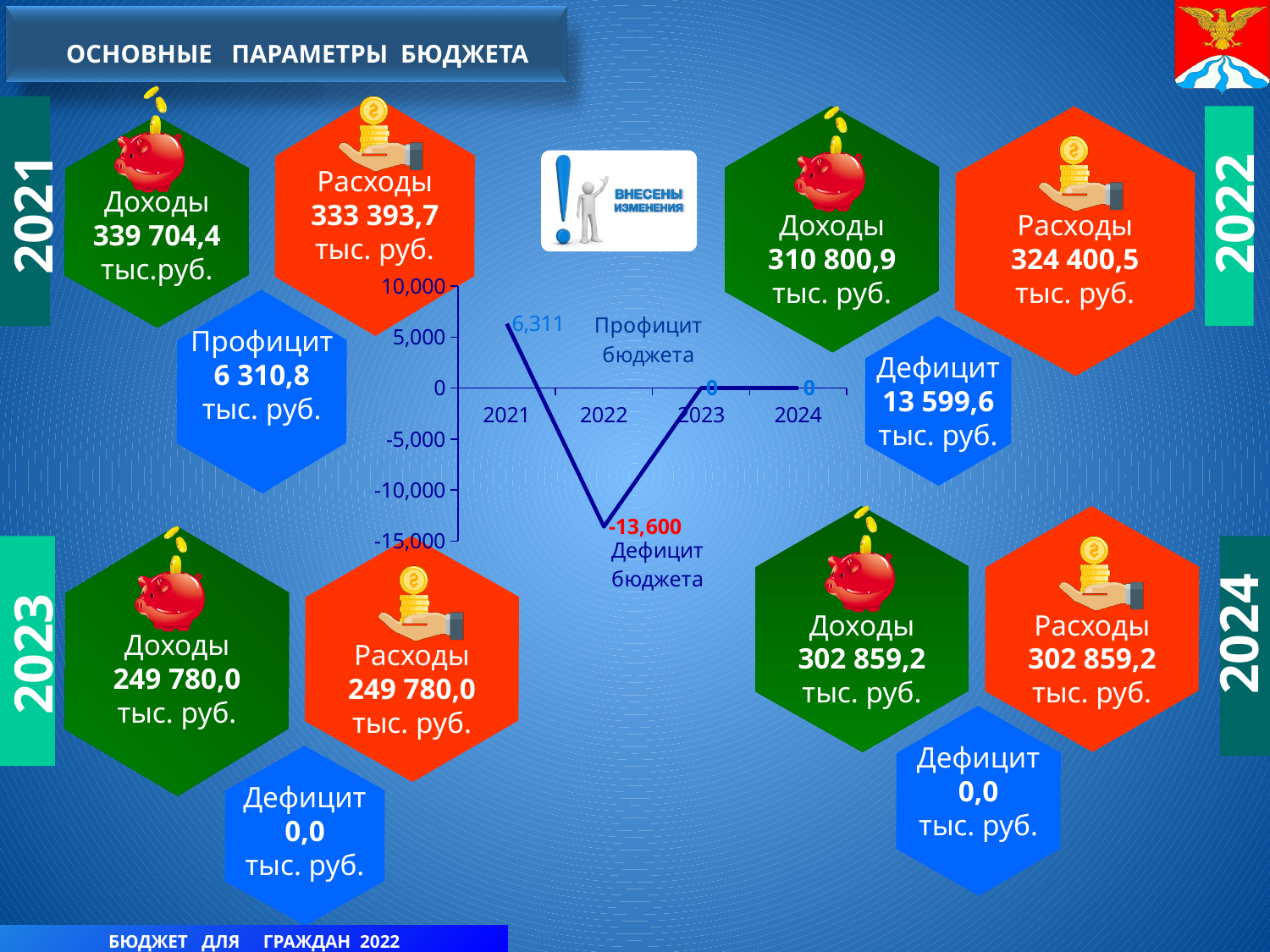
In the line chart, is the value for 2021 greater or less than 5,000? greater How many years are plotted on the x axis of the line chart? 4 In the line chart, is the value for 2022 greater or less than -10,000? less In the line chart, which year has the highest value? 2021 In the line chart, what is the difference between the 2021 value and the 2022 value? 19,911 In the line chart, what is the value plotted for 2021? 6,311 In the line chart, what is the value plotted for 2022? -13,600 In the line chart, which year has the lowest value? 2022 In the line chart, which year has the larger value, 2021 or 2022? 2021 What kind of chart is shown in the centre of the slide? line chart In the line chart, does the value rise or fall from 2021 to 2022? fall In the line chart, what is the value plotted for 2023? 0